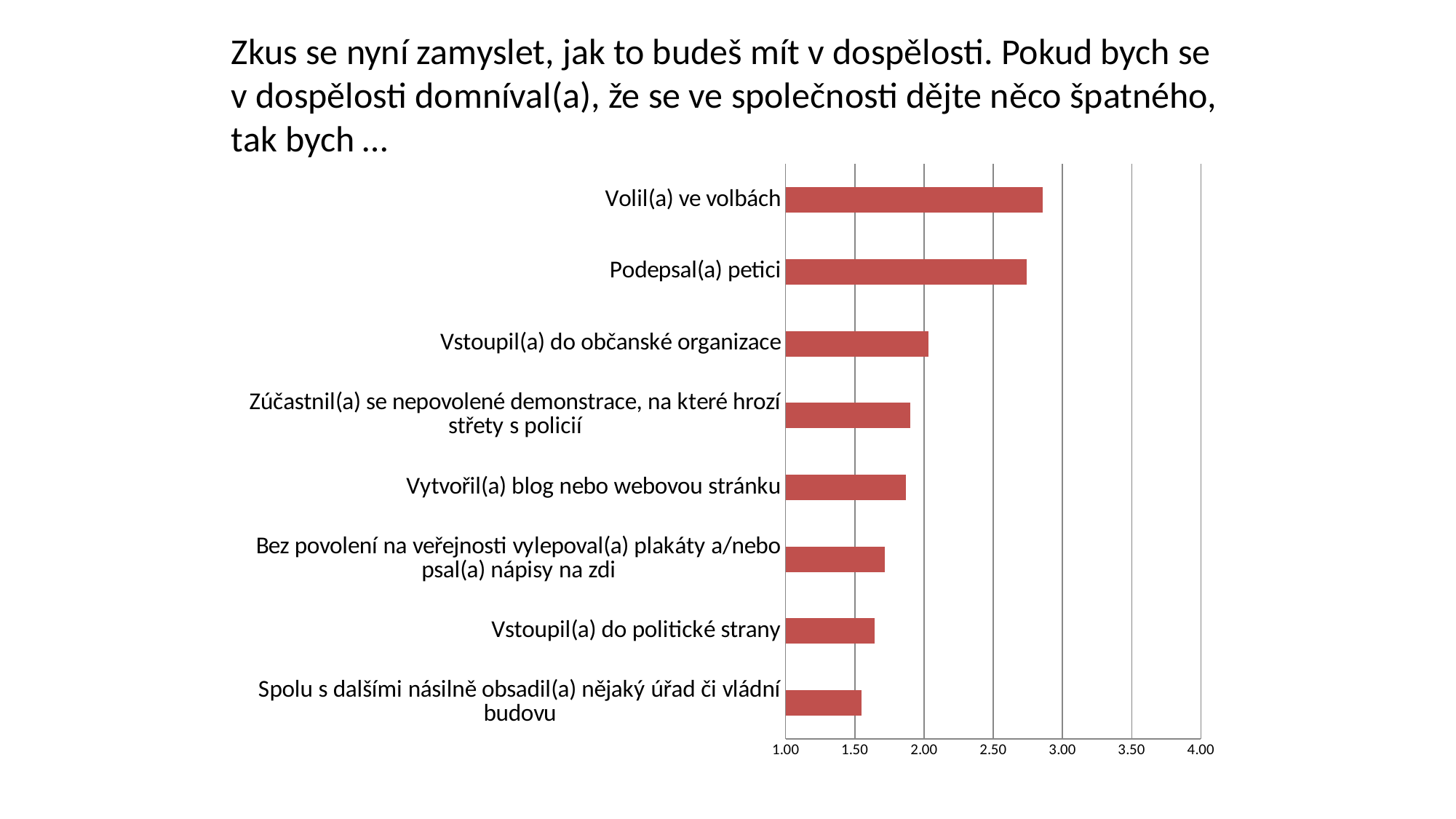
How many categories (bars) does the chart show? 8 Is the value for Vstoupil(a) do občanské organizace greater or less than 2.50? less Which has the larger value: Vstoupil(a) do občanské organizace or Vstoupil(a) do politické strany? Vstoupil(a) do občanské organizace Is the value for Spolu s dalšími násilně obsadil(a) nějaký úřad či vládní budovu greater or less than 2.00? less Is the value for Podepsal(a) petici greater or less than 2.50? greater Which has the larger value: Volil(a) ve volbách or Podepsal(a) petici? Volil(a) ve volbách What kind of chart is shown on the slide? bar chart Which category has the lowest value? Spolu s dalšími násilně obsadil(a) nějaký úřad či vládní budovu Which category has the highest value? Volil(a) ve volbách